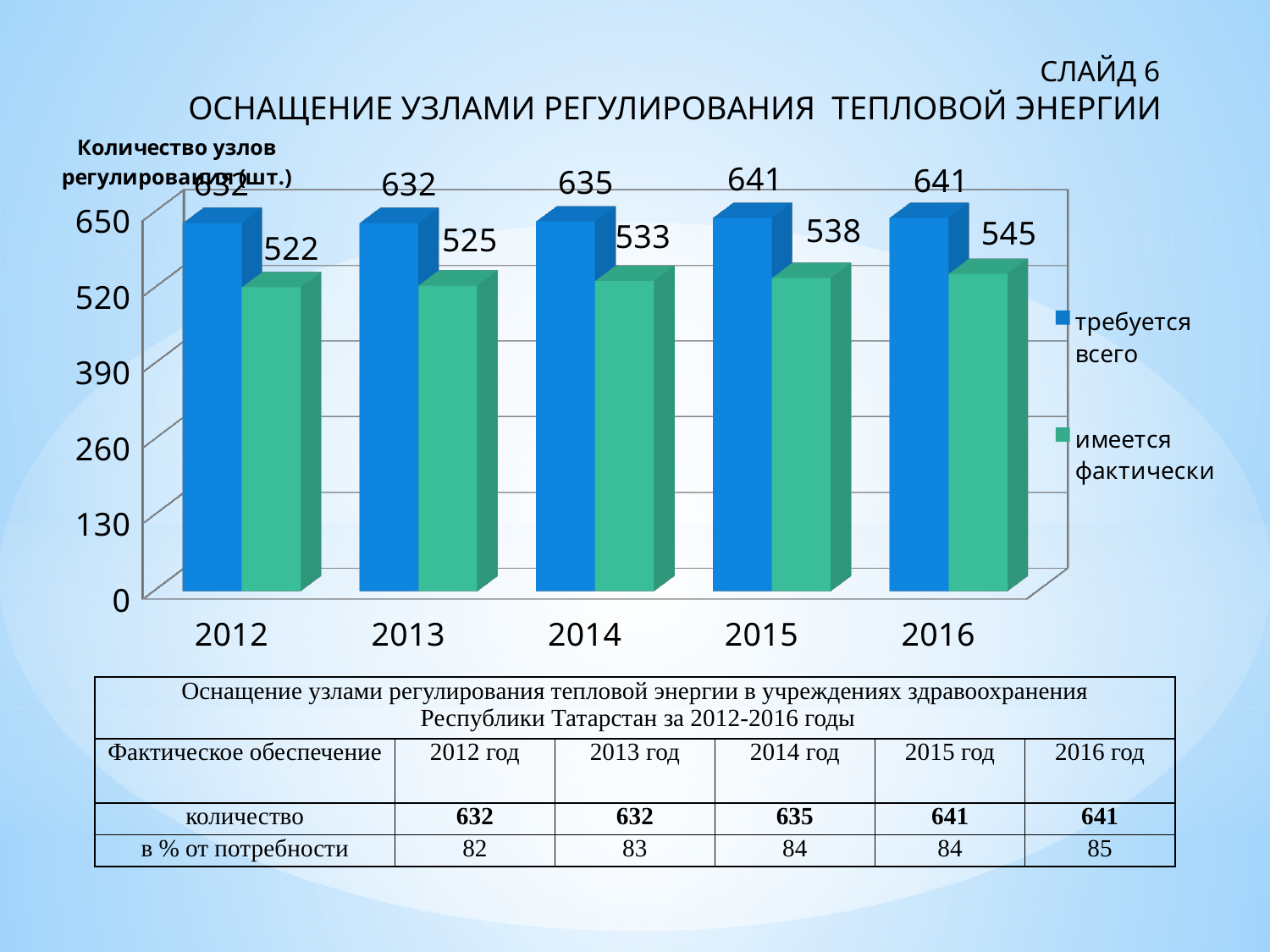
How many years are shown on the x axis of the chart? 5 How many series does the chart legend list? 2 Which is larger in 2013: "требуется всего" or "имеется фактически"? требуется всего In which year is "имеется фактически" the lowest? 2012 Does the value of "имеется фактически" rise or fall from 2012 to 2016? rise What is the value of "требуется всего" for 2014? 635 What is the value of "имеется фактически" for 2012? 522 What is the difference between "требуется всего" and "имеется фактически" in 2015? 103 What is the value of "имеется фактически" for 2016? 545 What type of chart is shown on the slide? bar chart In which year is "имеется фактически" the highest? 2016 What colour are the bars for "имеется фактически"? green